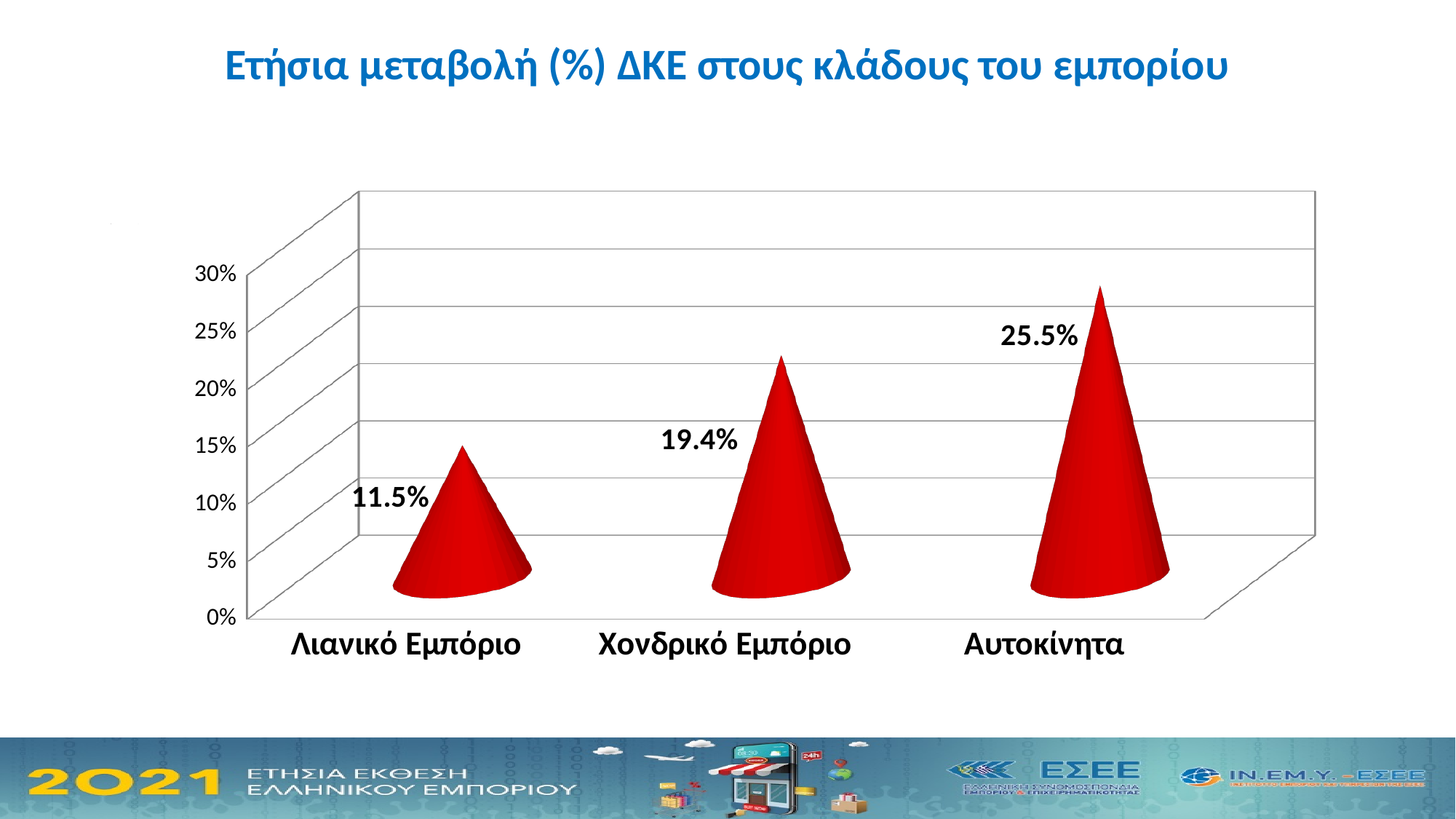
What is the value for Αυτοκίνητα? 25.5% Which is larger, the value for Χονδρικό Εμπόριο or the value for Αυτοκίνητα? Αυτοκίνητα What is the title of the chart? Ετήσια μεταβολή (%) ΔΚΕ στους κλάδους του εμπορίου Which category has the lowest value? Λιανικό Εμπόριο What is the value for Χονδρικό Εμπόριο? 19.4% Which category has the highest value? Αυτοκίνητα What is the difference between the values for Αυτοκίνητα and Λιανικό Εμπόριο? 14 percentage points What is the value for Λιανικό Εμπόριο? 11.5% What kind of chart is shown on the slide? Bar chart Is the value for Χονδρικό Εμπόριο greater or less than 15%? greater How many categories are shown on the chart? 3 What is the difference between the values for Χονδρικό Εμπόριο and Λιανικό Εμπόριο? 7.9 percentage points